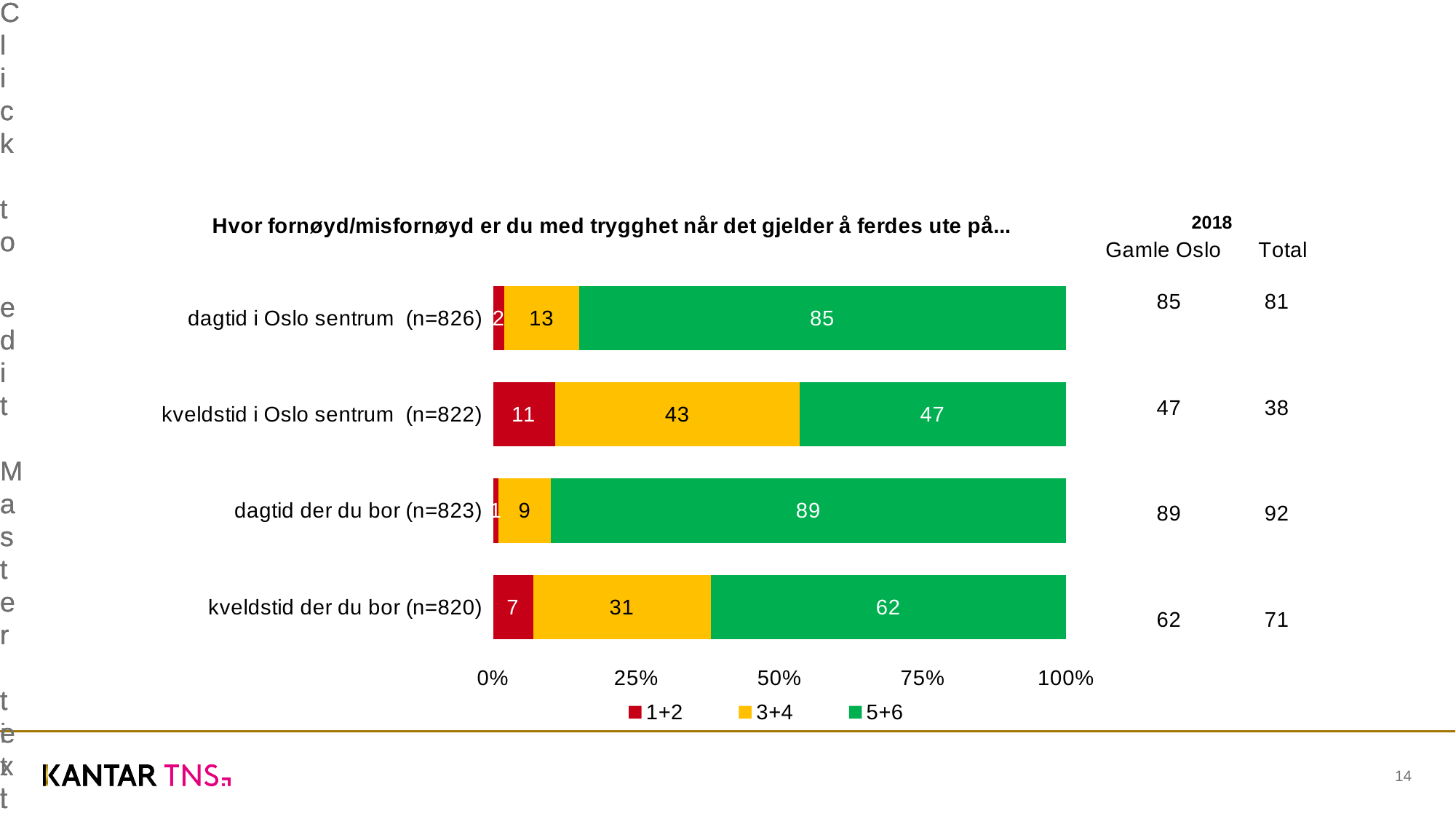
What is the value of the 5+6 series for 'dagtid i Oslo sentrum (n=826)'? 85 What is the difference between the 5+6 values for 'dagtid der du bor (n=823)' and 'kveldstid der du bor (n=820)'? 27 How many series does the legend list? 3 Which is larger: the 3+4 value for 'kveldstid i Oslo sentrum (n=822)' or the 3+4 value for 'kveldstid der du bor (n=820)'? kveldstid i Oslo sentrum (n=822) What is the value of the 3+4 series for 'kveldstid i Oslo sentrum (n=822)'? 43 Which category has the lowest value for the 5+6 series? kveldstid i Oslo sentrum (n=822) What kind of chart is shown on the slide? stacked bar chart Which category has the highest value for the 5+6 series? dagtid der du bor (n=823) How many categories are shown in the chart? 4 What is the value of the 1+2 series for 'kveldstid der du bor (n=820)'? 7 What colour represents the 5+6 series in the chart? green What is the total of the stacked bar for 'kveldstid der du bor (n=820)'? 100